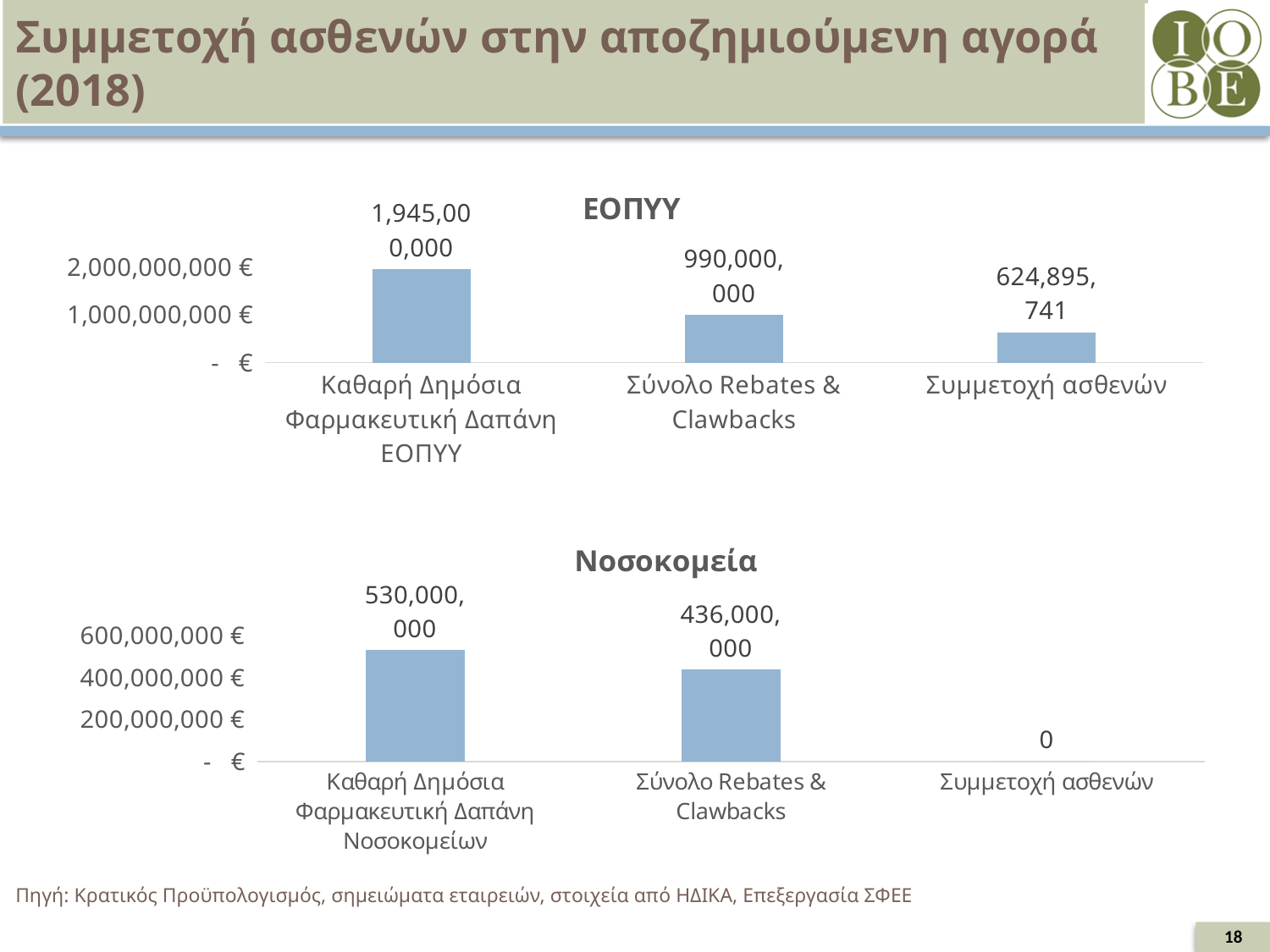
How many categories does the ΕΟΠΥΥ chart show? 3 In the Νοσοκομεία chart, what is the value for Συμμετοχή ασθενών? 0 In the ΕΟΠΥΥ chart, which category has the highest value? Καθαρή Δημόσια Φαρμακευτική Δαπάνη ΕΟΠΥΥ What kind of chart is the Νοσοκομεία chart? Bar chart In the Νοσοκομεία chart, which category has the lowest value? Συμμετοχή ασθενών In the Νοσοκομεία chart, what is the value for Σύνολο Rebates & Clawbacks? 436,000,000 In the ΕΟΠΥΥ chart, what is the difference between Σύνολο Rebates & Clawbacks and Συμμετοχή ασθενών? 365,104,259 In the ΕΟΠΥΥ chart, what is the value for Συμμετοχή ασθενών? 624,895,741 In the Νοσοκομεία chart, what is the value for Καθαρή Δημόσια Φαρμακευτική Δαπάνη Νοσοκομείων? 530,000,000 In the ΕΟΠΥΥ chart, what is the value for Σύνολο Rebates & Clawbacks? 990,000,000 In the ΕΟΠΥΥ chart, what is the value for Καθαρή Δημόσια Φαρμακευτική Δαπάνη ΕΟΠΥΥ? 1,945,000,000 In the Νοσοκομεία chart, what is the difference between Καθαρή Δημόσια Φαρμακευτική Δαπάνη Νοσοκομείων and Σύνολο Rebates & Clawbacks? 94,000,000